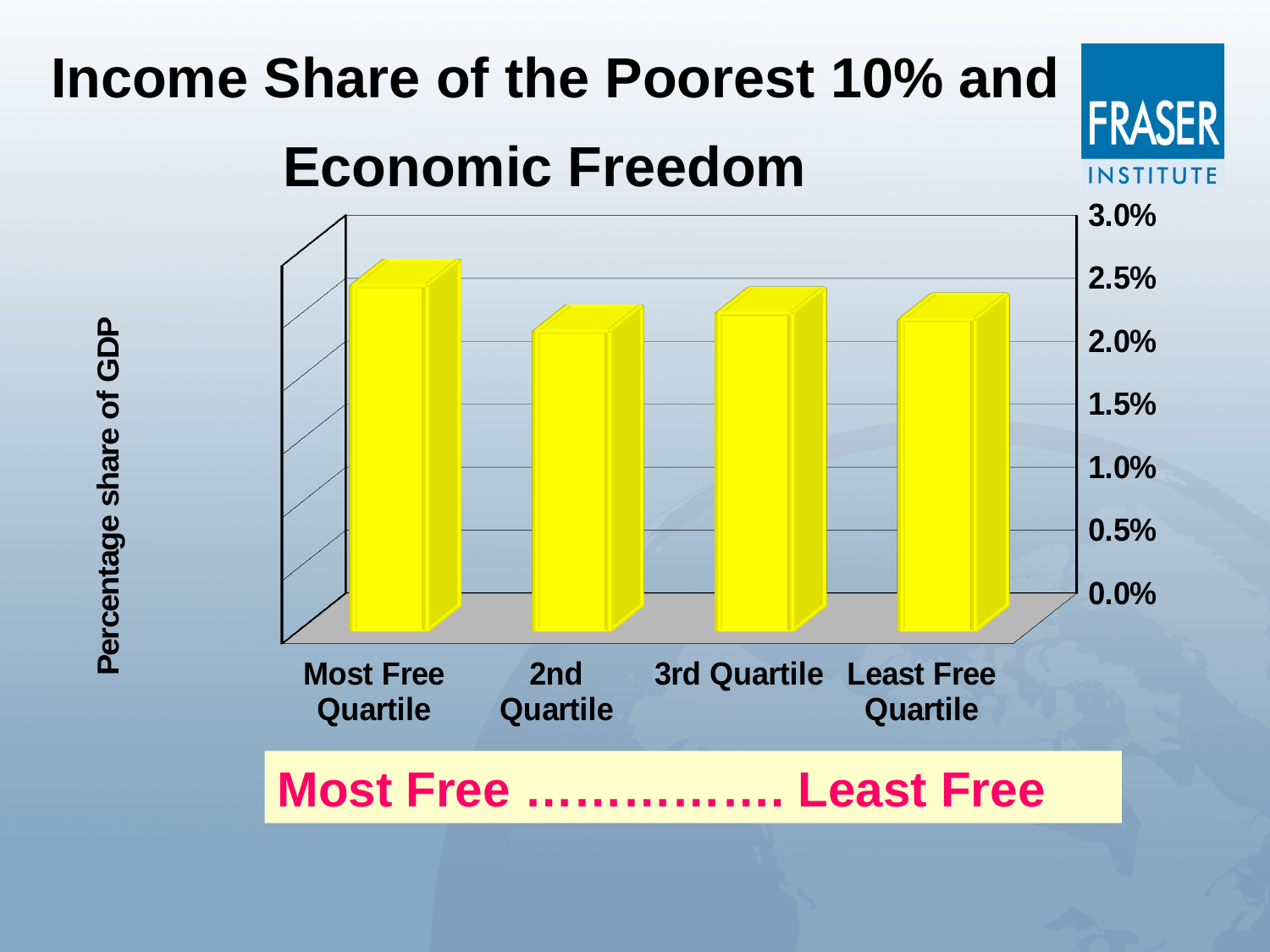
Which quartile has the highest income share of the poorest 10%? Most Free Quartile What colour are the bars in the chart? yellow Is the value for the Most Free Quartile greater or less than 2.0%? greater What is the label on the vertical axis of the chart? Percentage share of GDP Which is larger, the value for the Most Free Quartile or the Least Free Quartile? Most Free Quartile Is the value for the Most Free Quartile greater or less than 3.0%? less How many quartile categories are plotted in the chart? 4 Which is larger, the value for the 2nd Quartile or the 3rd Quartile? 3rd Quartile Is the value for the 2nd Quartile greater or less than 1.5%? greater What kind of chart is shown on the slide? bar chart